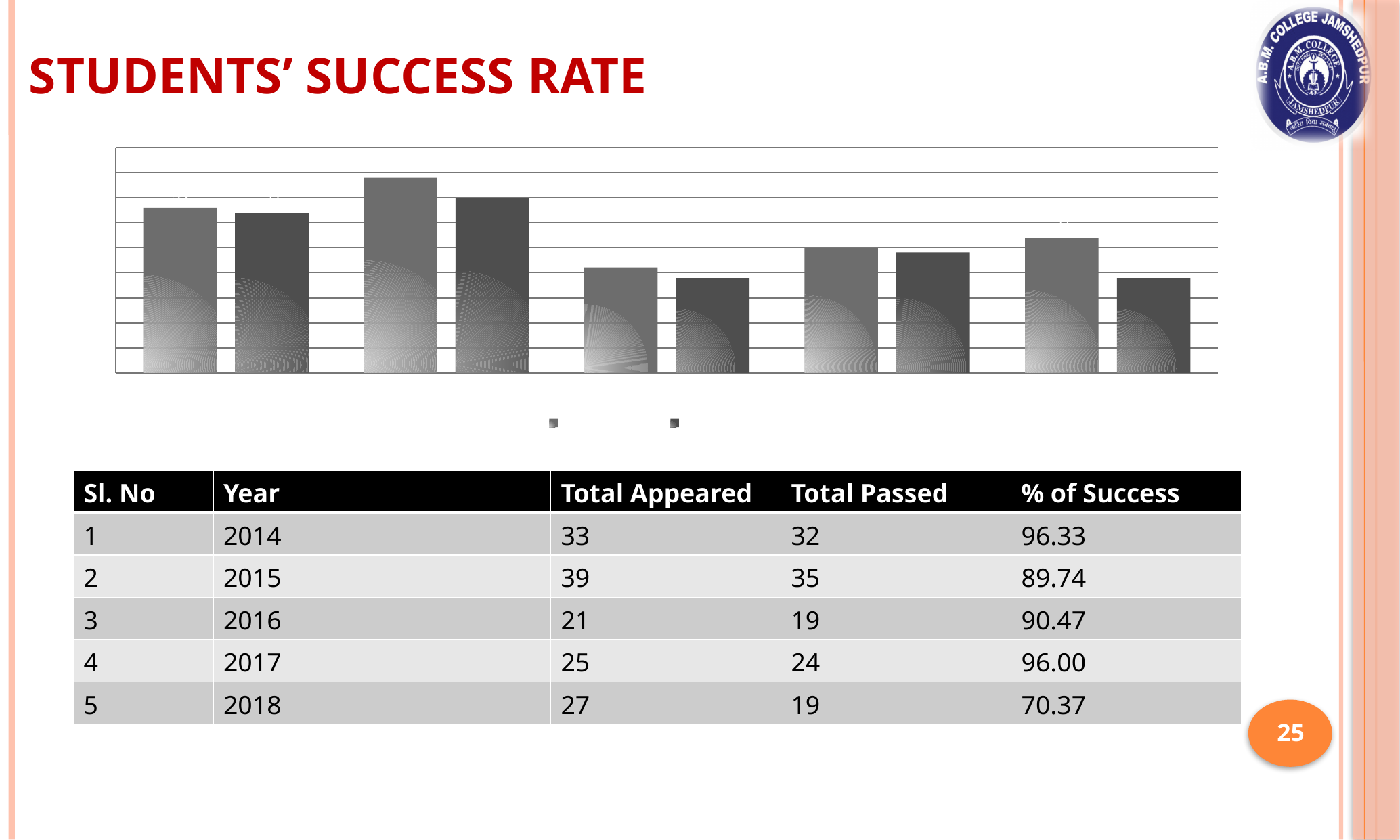
How many series markers does the chart's legend show? 2 Is the darker bar in the third group from the left taller or shorter than the darker bar in the second group? shorter How many groups of bars does the chart contain? 5 In every group of bars, is the lighter bar taller or shorter than the darker bar beside it? taller In the first group of bars from the left, which bar is taller, the lighter one or the darker one? the lighter one How many bars are plotted in the chart? 10 Are the bars in the chart vertical or horizontal? vertical Which group of bars, counting from the left, contains the tallest bar in the chart? second Does the chart display any readable axis labels or data labels? No What kind of chart is shown on the slide? bar chart